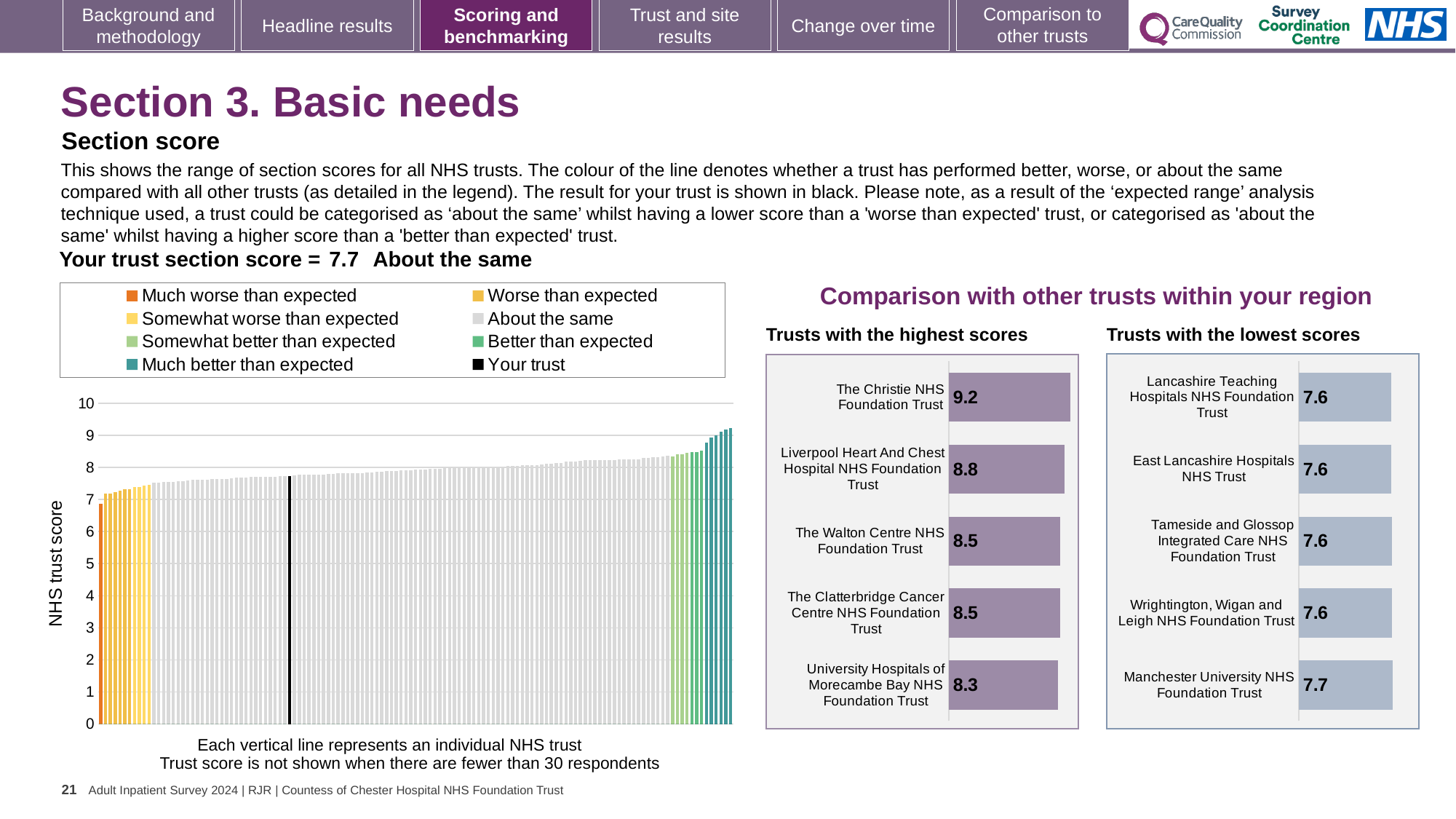
In the 'Trusts with the lowest scores' chart, what is the score for East Lancashire Hospitals NHS Trust? 7.6 In the 'Trusts with the highest scores' chart, what is the score for The Christie NHS Foundation Trust? 9.2 In the 'Trusts with the lowest scores' chart, what is the score for Manchester University NHS Foundation Trust? 7.7 In the 'Trusts with the lowest scores' chart, which is larger: the score for Manchester University NHS Foundation Trust or the score for Wrightington, Wigan and Leigh NHS Foundation Trust? Manchester University NHS Foundation Trust In the 'Trusts with the highest scores' chart, which trust has the highest score? The Christie NHS Foundation Trust In the 'Trusts with the lowest scores' chart, which trust has the highest score? Manchester University NHS Foundation Trust In the main 'NHS trust score' chart on the left, what kind of chart is it? Bar chart In the 'Trusts with the highest scores' chart, how many trusts are shown? 5 In the main 'NHS trust score' chart on the left, do the trust scores rise or fall from left to right along the x axis? Rise In the 'Trusts with the highest scores' chart, what is the score for University Hospitals of Morecambe Bay NHS Foundation Trust? 8.3 In the 'Trusts with the highest scores' chart, what is the difference between the scores of The Christie NHS Foundation Trust and University Hospitals of Morecambe Bay NHS Foundation Trust? 0.9 In the main 'NHS trust score' chart on the left, how many entries does the legend list? 8